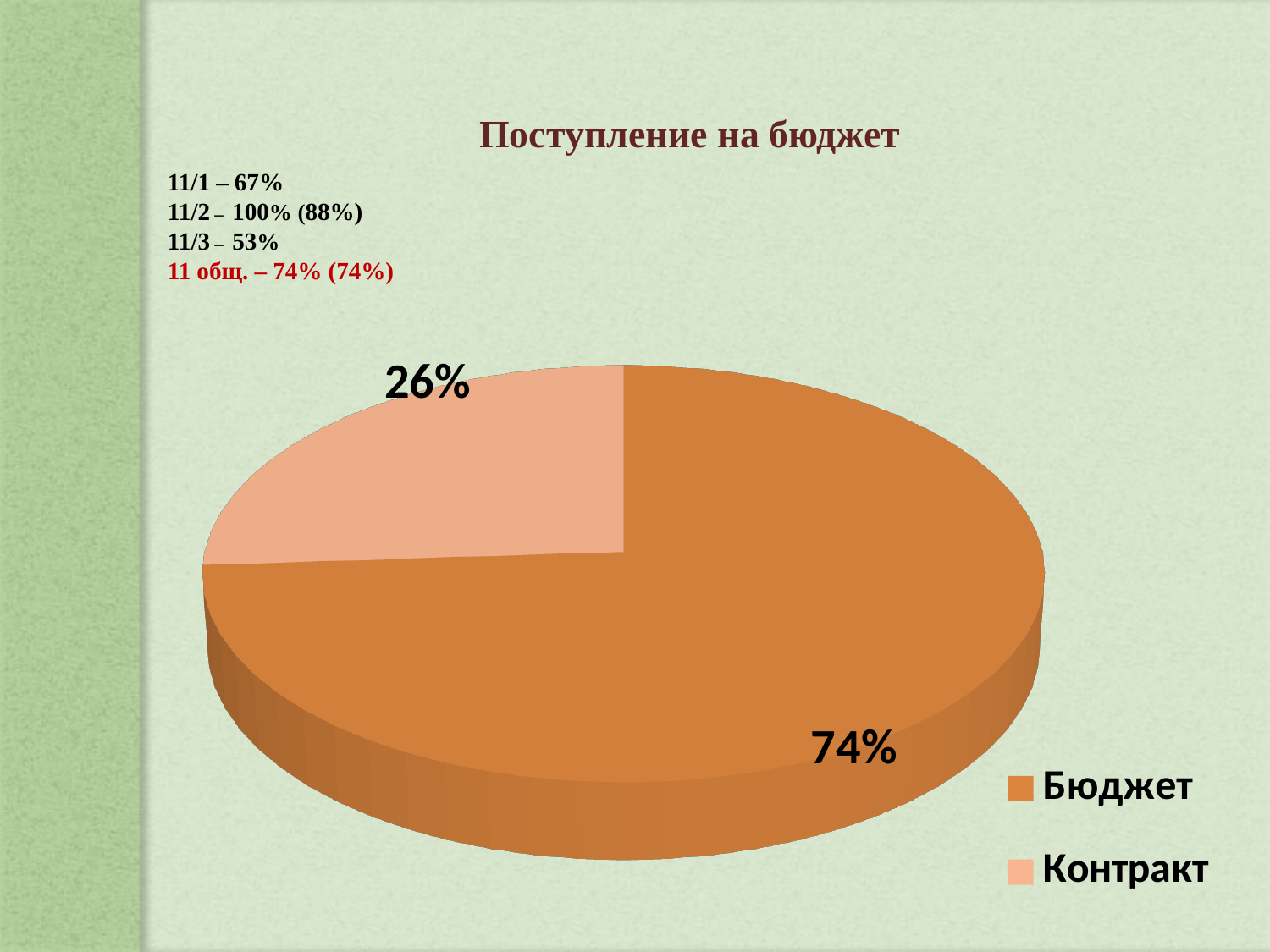
What is the value for Бюджет? 74% What share of the pie does Контракт take? 26% Which legend entry is shown in the lighter colour? Контракт Which is larger, Бюджет or Контракт? Бюджет Which slice is the largest? Бюджет What is the title of the chart? Поступление на бюджет Which slice is the smallest? Контракт What is the difference between the Бюджет and Контракт slices? 48% What kind of chart is shown on the slide? pie chart How many slices does the pie chart have? 2 What is the value for Контракт? 26% How many entries does the legend list? 2